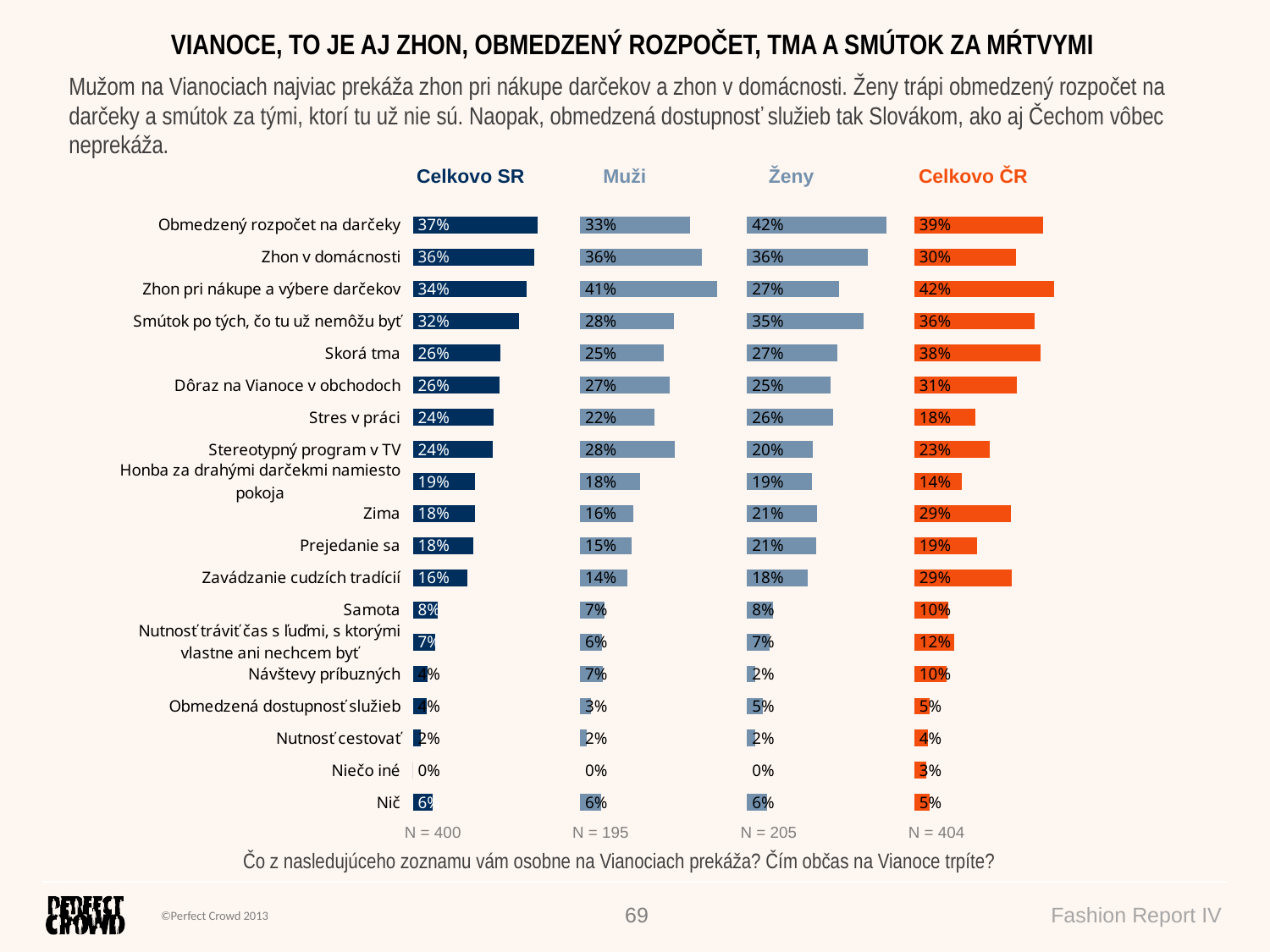
In the Celkovo ČR chart, which category has the highest value? Zhon pri nákupe a výbere darčekov For Zima, which is larger: the Celkovo SR value or the Celkovo ČR value? Celkovo ČR In the Muži chart, what is the value for Zhon pri nákupe a výbere darčekov? 41% In the Ženy chart, what is the value for Smútok po tých, čo tu už nemôžu byť? 35% In the Celkovo SR chart, what is the value for Obmedzený rozpočet na darčeky? 37% What type of chart is used to show the Celkovo SR values? Bar chart What is the sample size (N) shown under the Ženy chart? N = 205 What colour are the bars in the Celkovo ČR chart? Orange In the Celkovo ČR chart, what is the value for Skorá tma? 38% What is the difference between the Ženy and Muži values for Obmedzený rozpočet na darčeky? 9 percentage points In the Muži chart, which category has the lowest value? Niečo iné How many categories are listed in the Celkovo SR chart? 19